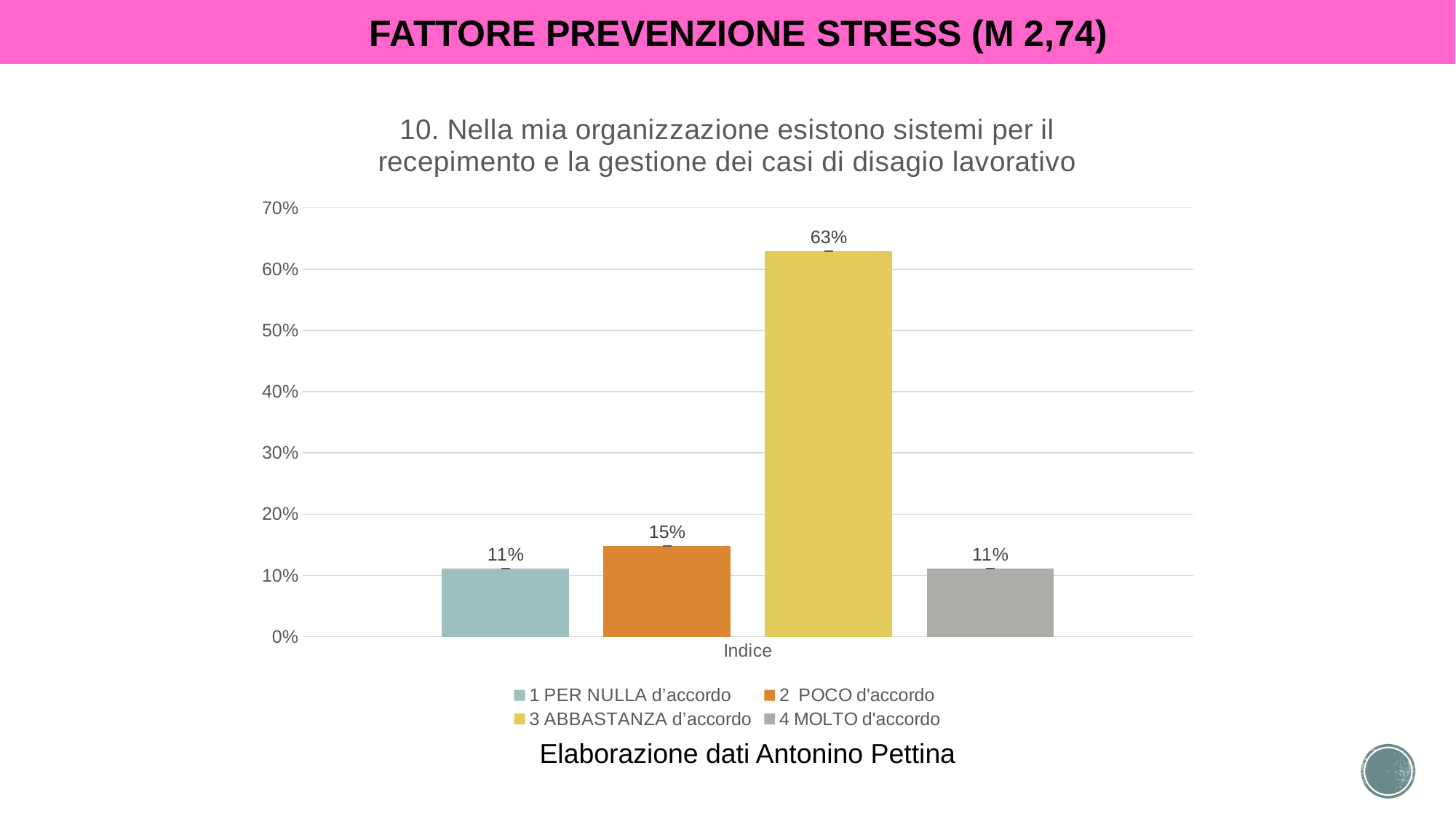
What is the value for "1 PER NULLA d'accordo"? 11% What kind of chart is shown on the slide? Bar chart Which series has the highest value? 3 ABBASTANZA d'accordo What is the value for "3 ABBASTANZA d'accordo"? 63% What is the value for "2 POCO d'accordo"? 15% Which is larger, the value for "2 POCO d'accordo" or the value for "4 MOLTO d'accordo"? 2 POCO d'accordo What is the label on the x axis below the bars? Indice What is the value for "4 MOLTO d'accordo"? 11% What is the difference between the values for "2 POCO d'accordo" and "1 PER NULLA d'accordo"? 4% What is the difference between the values for "3 ABBASTANZA d'accordo" and "2 POCO d'accordo"? 48% Is the value for "3 ABBASTANZA d'accordo" greater or less than 60%? greater How many series does the legend list? 4